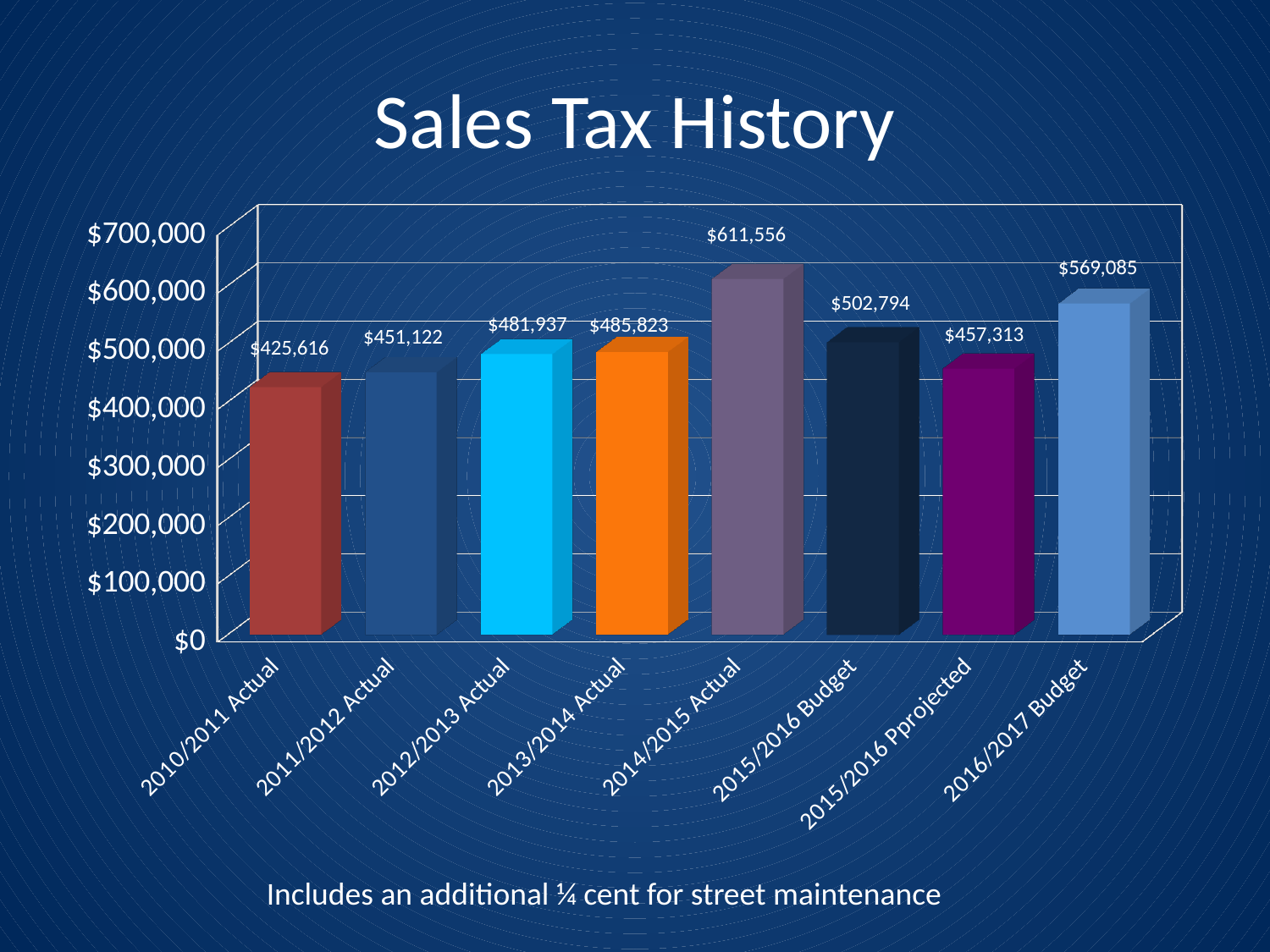
What is the value for 2015/2016 Budget? $502,794 What is the title of the chart? Sales Tax History What is the difference between the values for 2016/2017 Budget and 2015/2016 Budget? $66,291 How many categories are shown on the x axis? 8 What is the value for 2016/2017 Budget? $569,085 What is the difference between the values for 2014/2015 Actual and 2010/2011 Actual? $185,940 Which is larger, the value for 2015/2016 Budget or the value for 2015/2016 Pprojected? 2015/2016 Budget What kind of chart is shown on the slide? Bar chart Which category has the lowest value? 2010/2011 Actual What is the value for 2014/2015 Actual? $611,556 What is the value for 2010/2011 Actual? $425,616 Which category has the highest value? 2014/2015 Actual